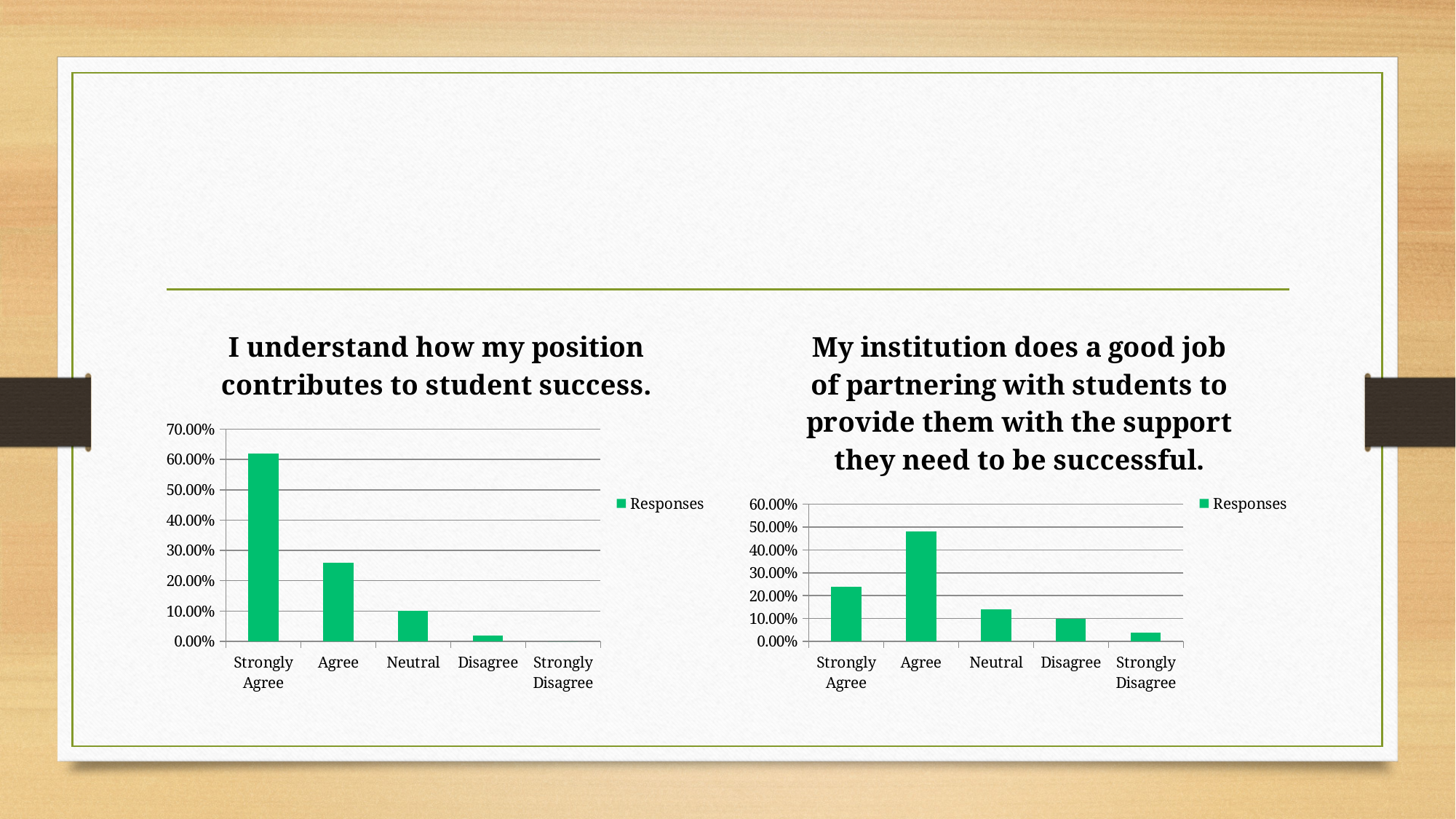
What type of chart is the chart on the right of the slide? Bar chart In the chart titled "I understand how my position contributes to student success.", is the value for Strongly Agree greater or less than 60.00%? greater In the chart titled "I understand how my position contributes to student success.", which is larger, Agree or Neutral? Agree How many series does the legend list in the chart on the left of the slide? 1 In the chart titled "I understand how my position contributes to student success.", is the value for Agree greater or less than 30.00%? less In the chart titled "My institution does a good job of partnering with students to provide them with the support they need to be successful.", which category has the highest value? Agree In the chart titled "My institution does a good job of partnering with students to provide them with the support they need to be successful.", which category has the lowest value? Strongly Disagree In the chart titled "I understand how my position contributes to student success.", which category has the highest value? Strongly Agree How many categories are shown on the x axis of the chart titled "I understand how my position contributes to student success."? 5 In the chart titled "My institution does a good job of partnering with students to provide them with the support they need to be successful.", is the value for Agree greater or less than 40.00%? greater In the chart titled "My institution does a good job of partnering with students to provide them with the support they need to be successful.", which is larger, Strongly Agree or Neutral? Strongly Agree